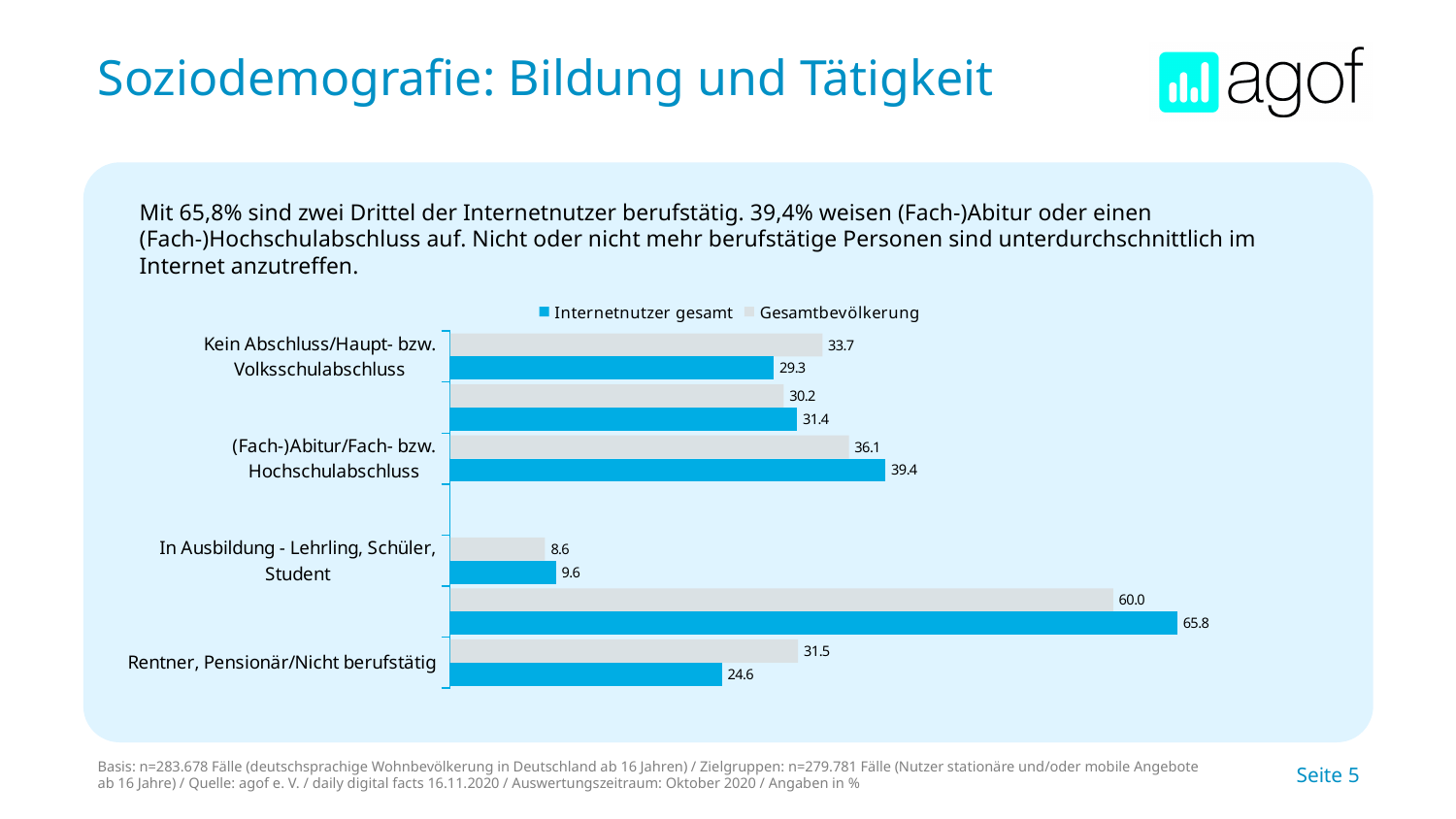
What is the value for Internetnutzer gesamt in the category (Fach-)Abitur/Fach- bzw. Hochschulabschluss? 39.4 What is the value for Internetnutzer gesamt in the category Rentner, Pensionär/Nicht berufstätig? 24.6 What is the lowest value shown for the Gesamtbevölkerung series? 8.6 What is the highest value shown for the Internetnutzer gesamt series? 65.8 What kind of chart is shown on the slide? Bar chart What is the difference between Gesamtbevölkerung and Internetnutzer gesamt for Rentner, Pensionär/Nicht berufstätig? 6.9 How many series does the legend list? 2 For In Ausbildung - Lehrling, Schüler, Student, which series has the larger value: Internetnutzer gesamt or Gesamtbevölkerung? Internetnutzer gesamt What is the difference between Internetnutzer gesamt and Gesamtbevölkerung for (Fach-)Abitur/Fach- bzw. Hochschulabschluss? 3.3 For Kein Abschluss/Haupt- bzw. Volksschulabschluss, which series has the larger value: Internetnutzer gesamt or Gesamtbevölkerung? Gesamtbevölkerung What is the value for Gesamtbevölkerung in the category In Ausbildung - Lehrling, Schüler, Student? 8.6 What is the value for Gesamtbevölkerung in the category Kein Abschluss/Haupt- bzw. Volksschulabschluss? 33.7